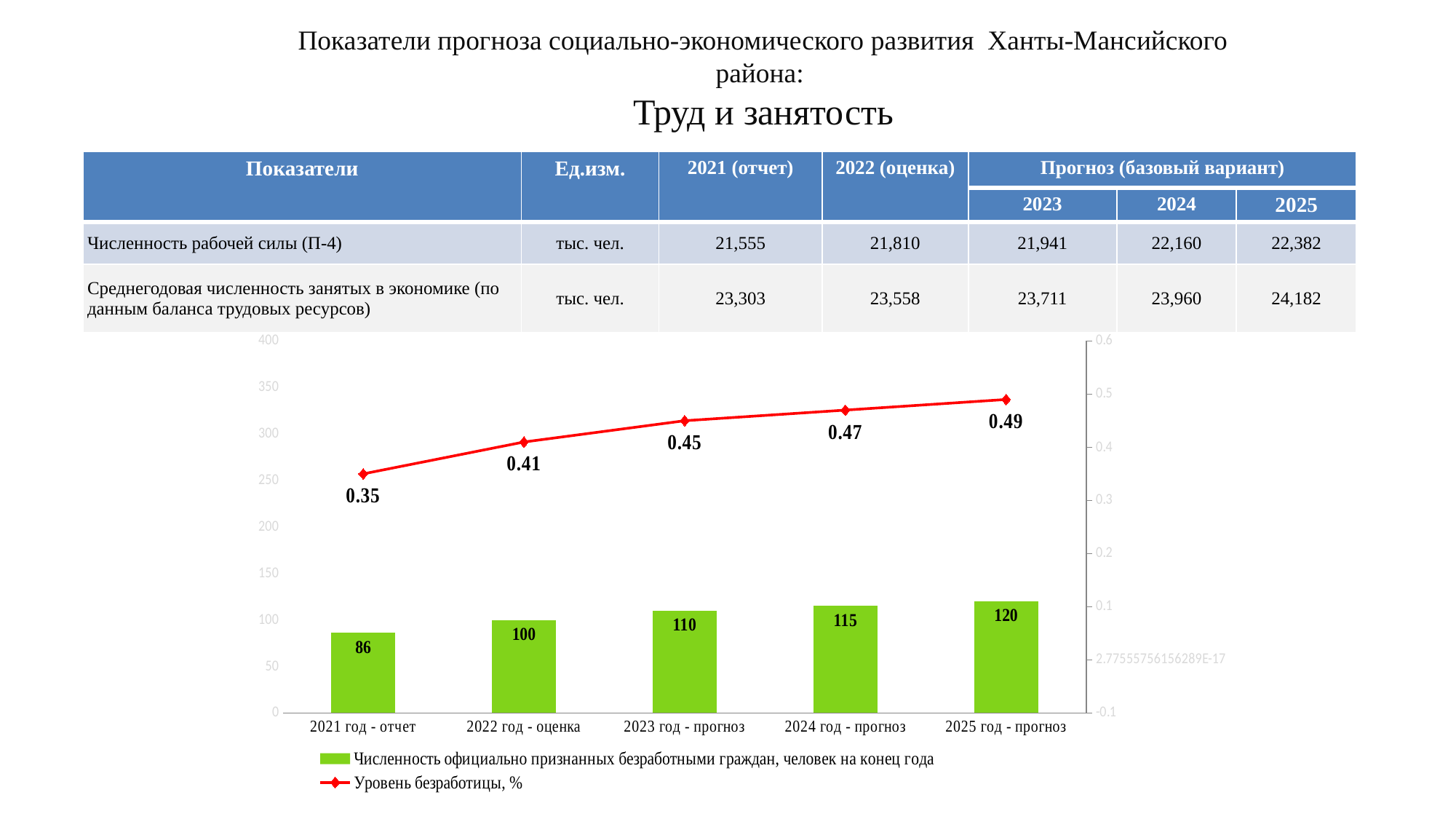
Which category has the highest bar value? 2025 год - прогноз What is the value of the bar for 2021 год - отчет? 86 Do the unemployment rate values rise or fall from 2021 to 2025? Rise How many series does the legend list? 2 What kind of chart is shown on the slide? Combined bar and line chart Which is larger: the bar value for 2023 год - прогноз or for 2024 год - прогноз? 2024 год - прогноз What colour are the bars in the chart? Green How many categories are shown on the x axis? 5 Which category has the lowest unemployment rate on the line? 2021 год - отчет What is the value of the bar for 2025 год - прогноз? 120 What is the difference between the bar values for 2025 год - прогноз and 2021 год - отчет? 34 What is the unemployment rate (Уровень безработицы, %) shown for 2023 год - прогноз? 0.45